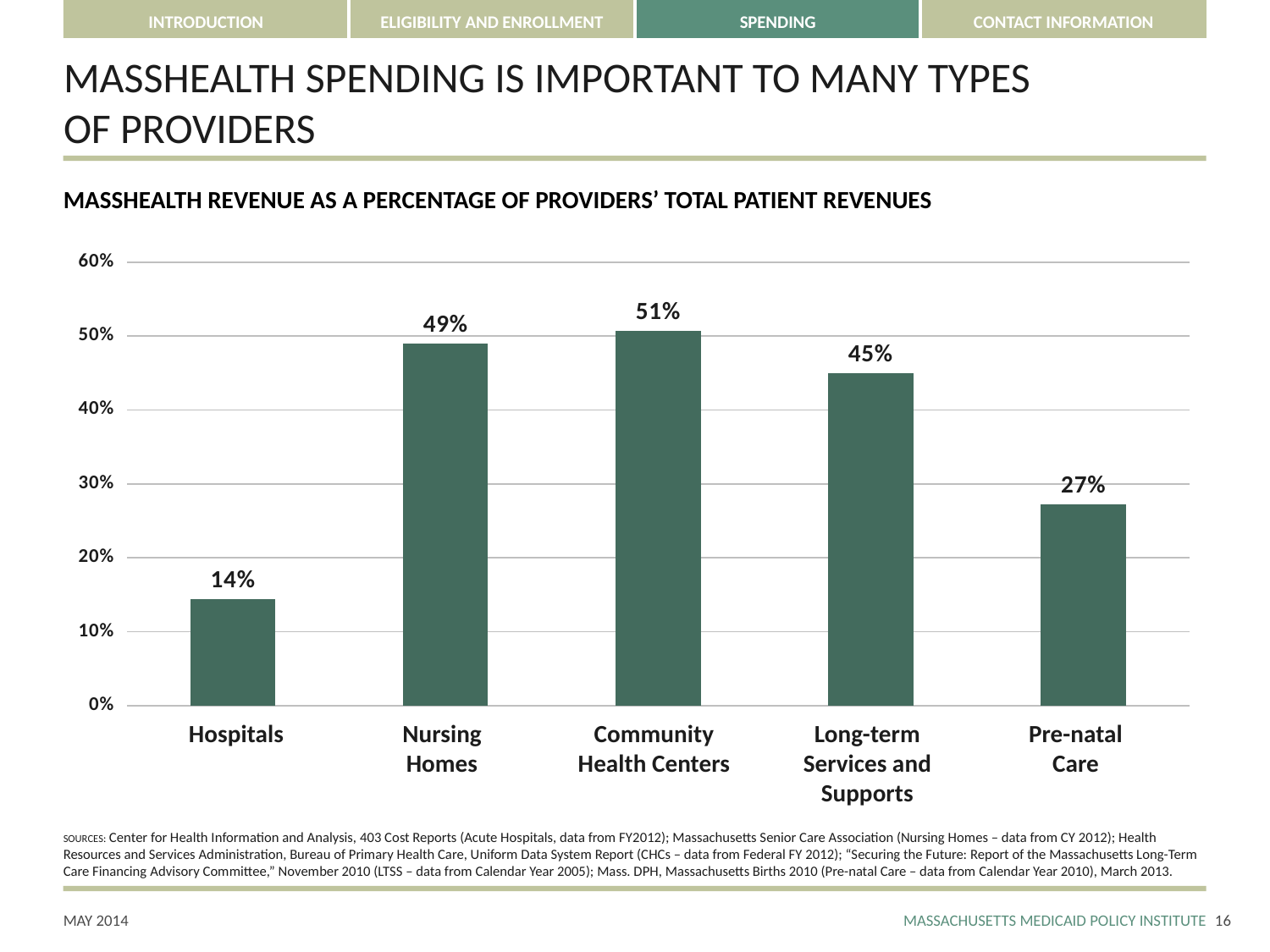
What is the MassHealth revenue percentage for Hospitals? 14% What is the MassHealth revenue percentage for Pre-natal Care? 27% Is the value for Nursing Homes greater or less than 40%? greater What is the highest value shown on the vertical axis? 60% What is the title of the chart? MassHealth Revenue as a Percentage of Providers' Total Patient Revenues Which provider type has the lowest MassHealth revenue percentage? Hospitals What kind of chart is shown on the slide? Bar chart How many provider types are shown in the chart? 5 What is the MassHealth revenue percentage for Community Health Centers? 51% Which is larger, the percentage for Long-term Services and Supports or for Pre-natal Care? Long-term Services and Supports What is the difference between the percentages for Nursing Homes and Pre-natal Care? 22% Which provider type has the highest MassHealth revenue percentage? Community Health Centers